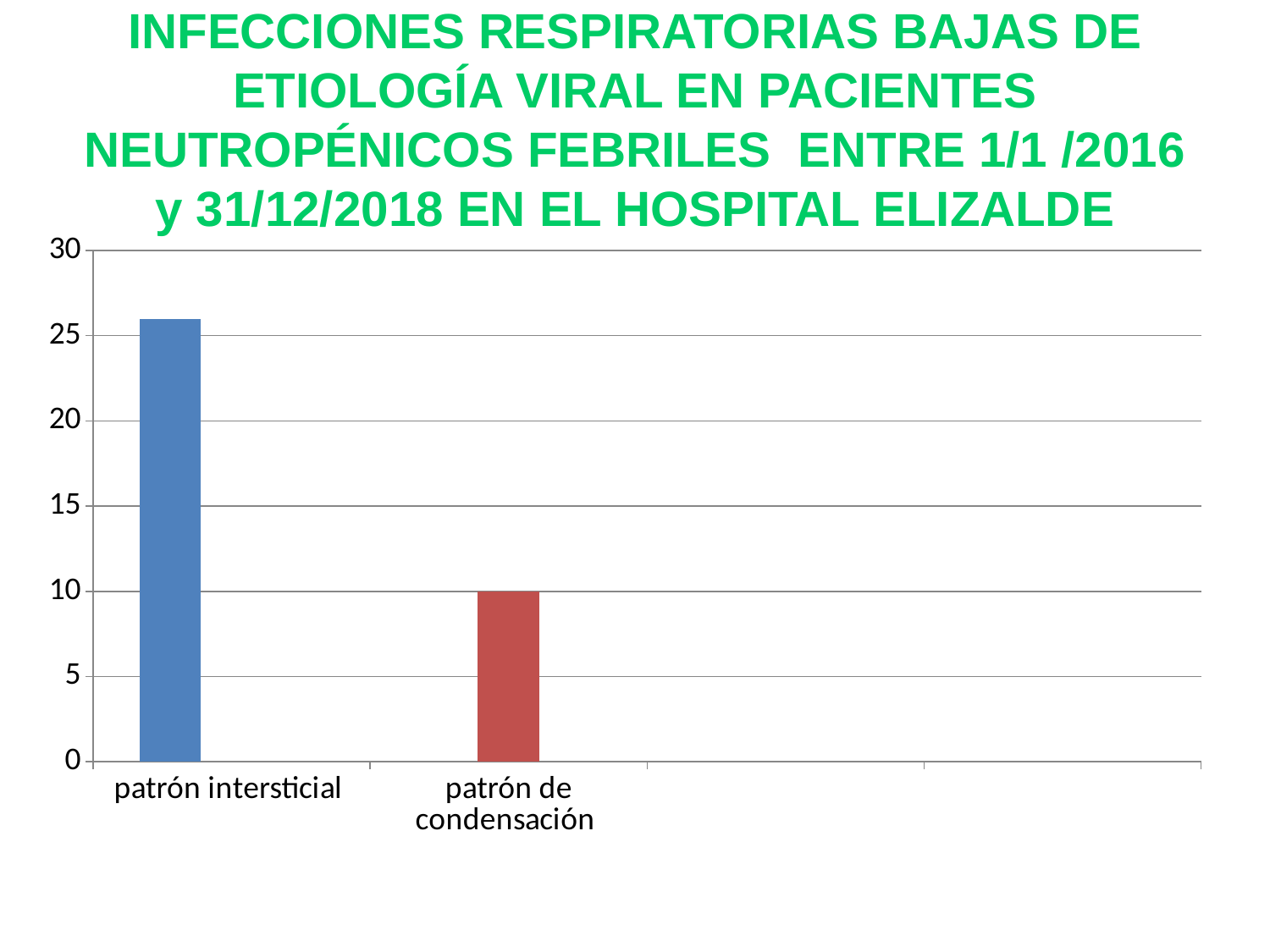
What is the value for patrón de condensación? 10 Is the value for patrón de condensación greater or less than 15? less Is the value for patrón intersticial greater or less than 25? greater Which is larger, the value for patrón intersticial or the value for patrón de condensación? patrón intersticial Which category has the lowest value? patrón de condensación Is the value for patrón de condensación greater or less than 5? greater How many bars are plotted in the chart? 2 What is the maximum value shown on the vertical axis? 30 What colour is the bar for patrón de condensación? red Which category has the highest value? patrón intersticial What type of chart is shown on the slide? bar chart